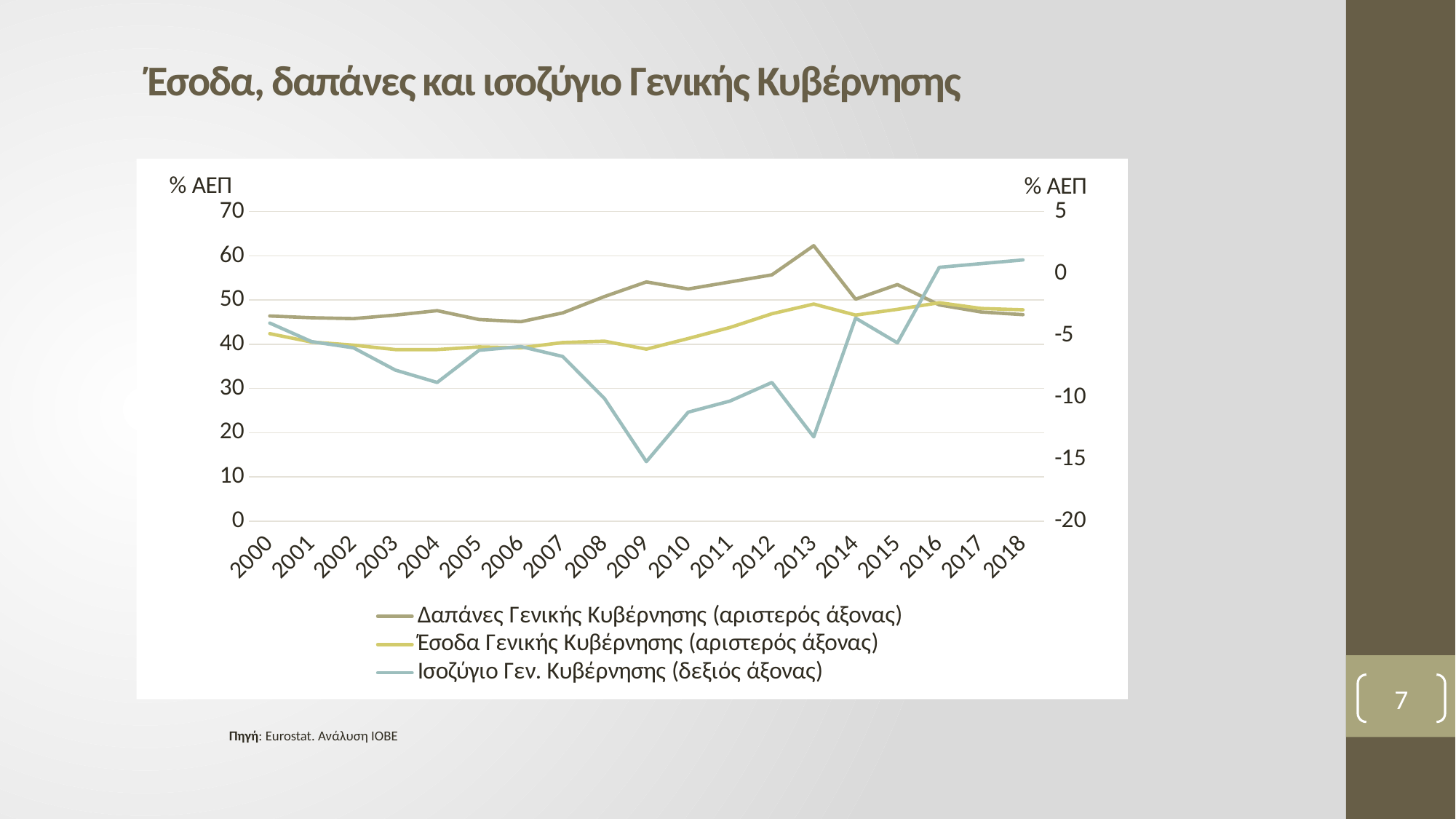
Is the value for Δαπάνες Γενικής Κυβέρνησης in 2013 greater or less than 60? greater What kind of chart is shown on the slide? Line chart How many years are shown on the x axis? 19 Is the value for Ισοζύγιο Γεν. Κυβέρνησης in 2009 greater or less than -10? less In which year does the Ισοζύγιο Γεν. Κυβέρνησης line reach its lowest value? 2009 How many series does the legend list? 3 Is the value for Δαπάνες Γενικής Κυβέρνησης in 2006 greater or less than 50? less What is the title of the slide? Έσοδα, δαπάνες και ισοζύγιο Γενικής Κυβέρνησης Which is larger in 2009, Δαπάνες Γενικής Κυβέρνησης or Έσοδα Γενικής Κυβέρνησης? Δαπάνες Γενικής Κυβέρνησης Does the Ισοζύγιο Γεν. Κυβέρνησης line rise or fall from 2013 to 2016? Rise In which year does the Δαπάνες Γενικής Κυβέρνησης line reach its highest value? 2013 Which series is plotted on the right axis according to the legend? Ισοζύγιο Γεν. Κυβέρνησης (δεξιός άξονας)